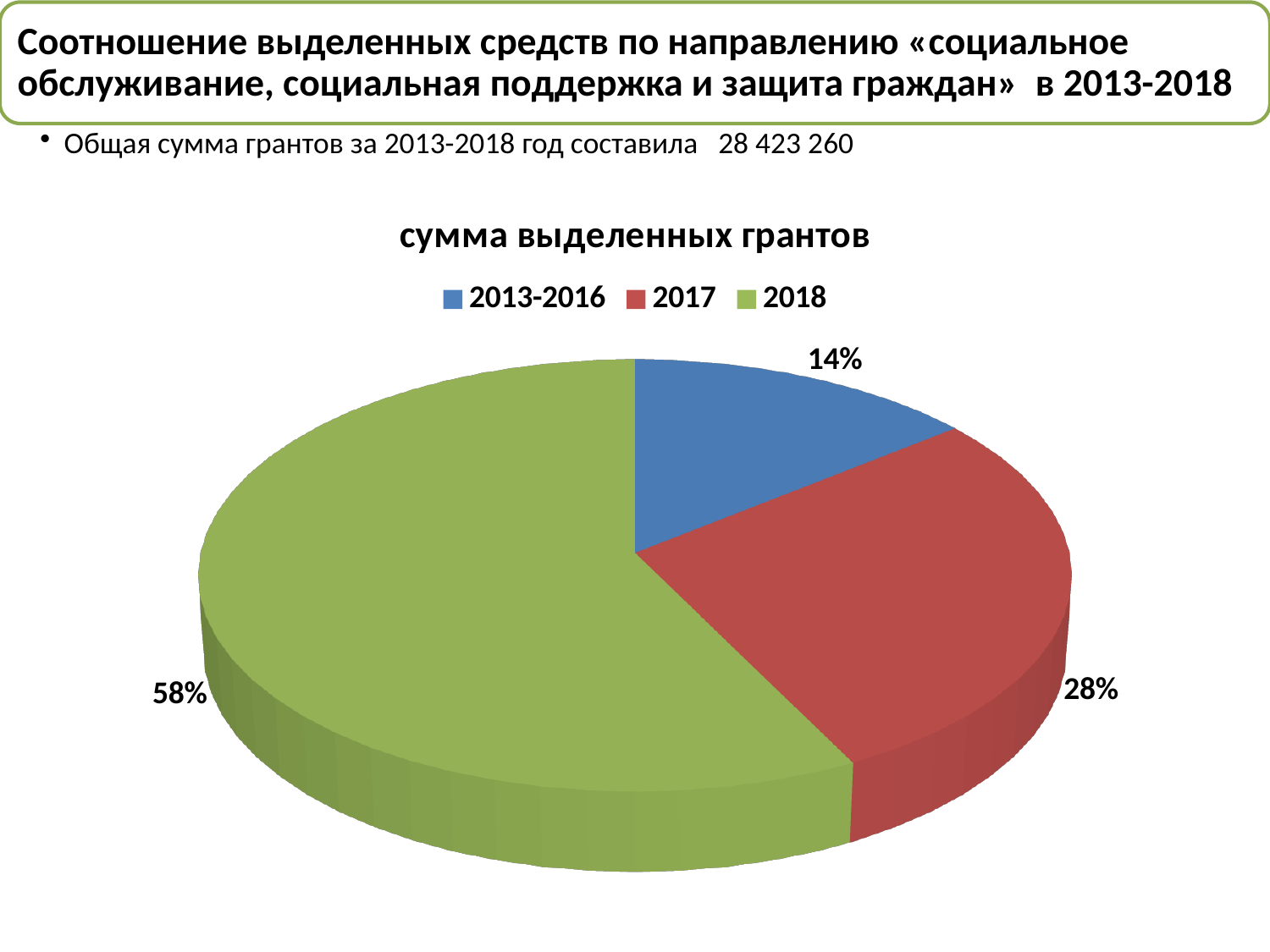
What is the title of the chart? сумма выделенных грантов What colour is the 2018 slice in the pie chart? Green What share of the pie does the 2018 slice represent? 58% Which is larger, the share for 2017 or the share for 2013-2016? 2017 What share of the pie does the 2013-2016 slice represent? 14% Which category has the largest share of the pie? 2018 Which category has the smallest share of the pie? 2013-2016 What is the difference in percentage points between the 2018 share and the 2017 share? 30 What kind of chart is shown on the slide? Pie chart How many slices does the pie chart have? 3 What share of the pie does the 2017 slice represent? 28% What is the difference in percentage points between the 2017 share and the 2013-2016 share? 14